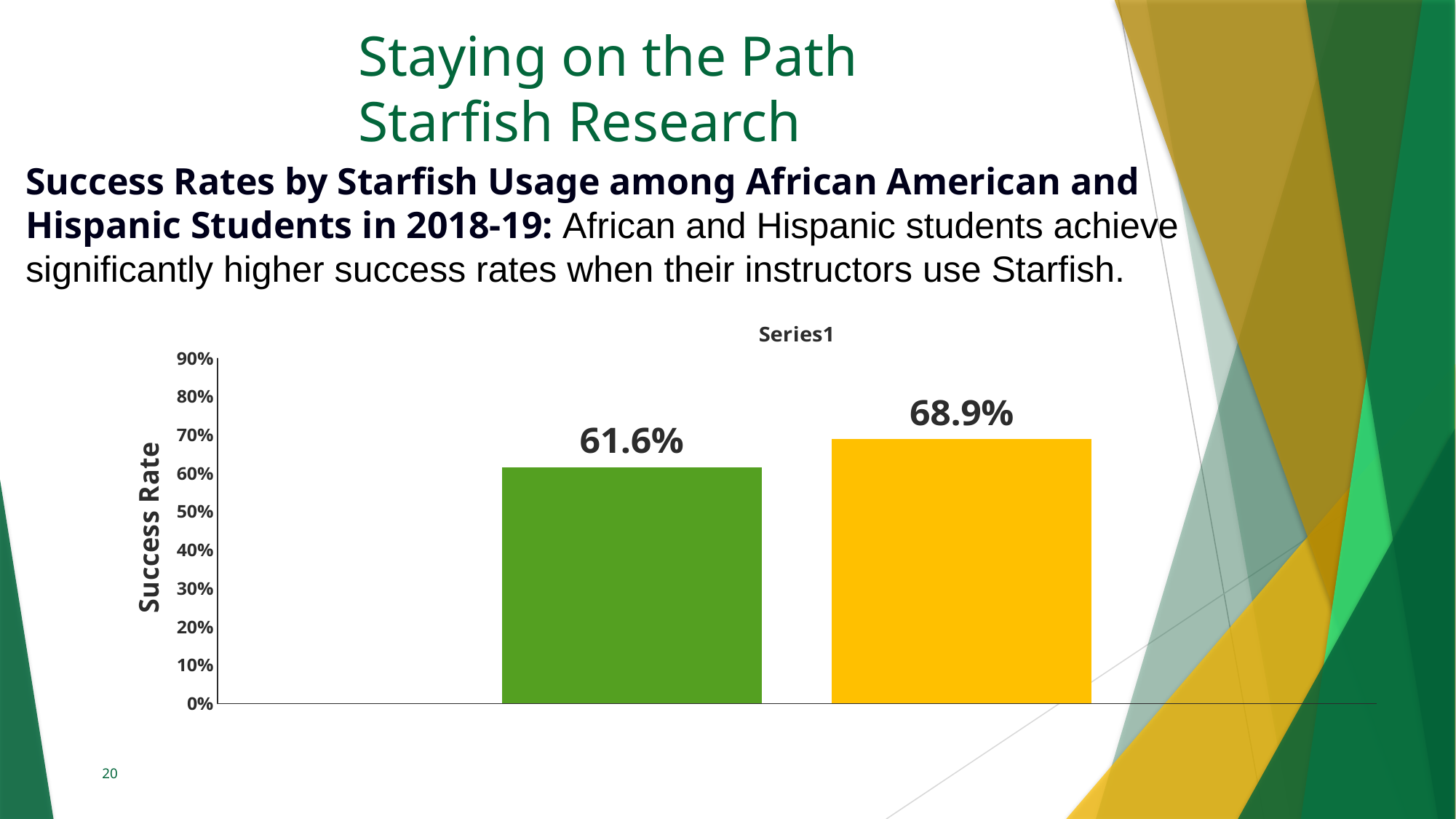
What is the lowest value shown in the chart? 61.6% What value is shown on the green bar in the chart? 61.6% Is the value of the green bar greater or less than 60%? greater How many bars are plotted in the chart? 2 Which bar has the higher value, the green bar or the yellow bar? the yellow bar What is the highest value shown in the chart? 68.9% What is the difference between the yellow bar's value and the green bar's value? 7.3 percentage points What value is shown on the yellow bar in the chart? 68.9% What kind of chart is shown on the slide? bar chart Is the value of the yellow bar greater or less than 70%? less What is the title shown above the chart? Series1 What is the label on the vertical axis of the chart? Success Rate